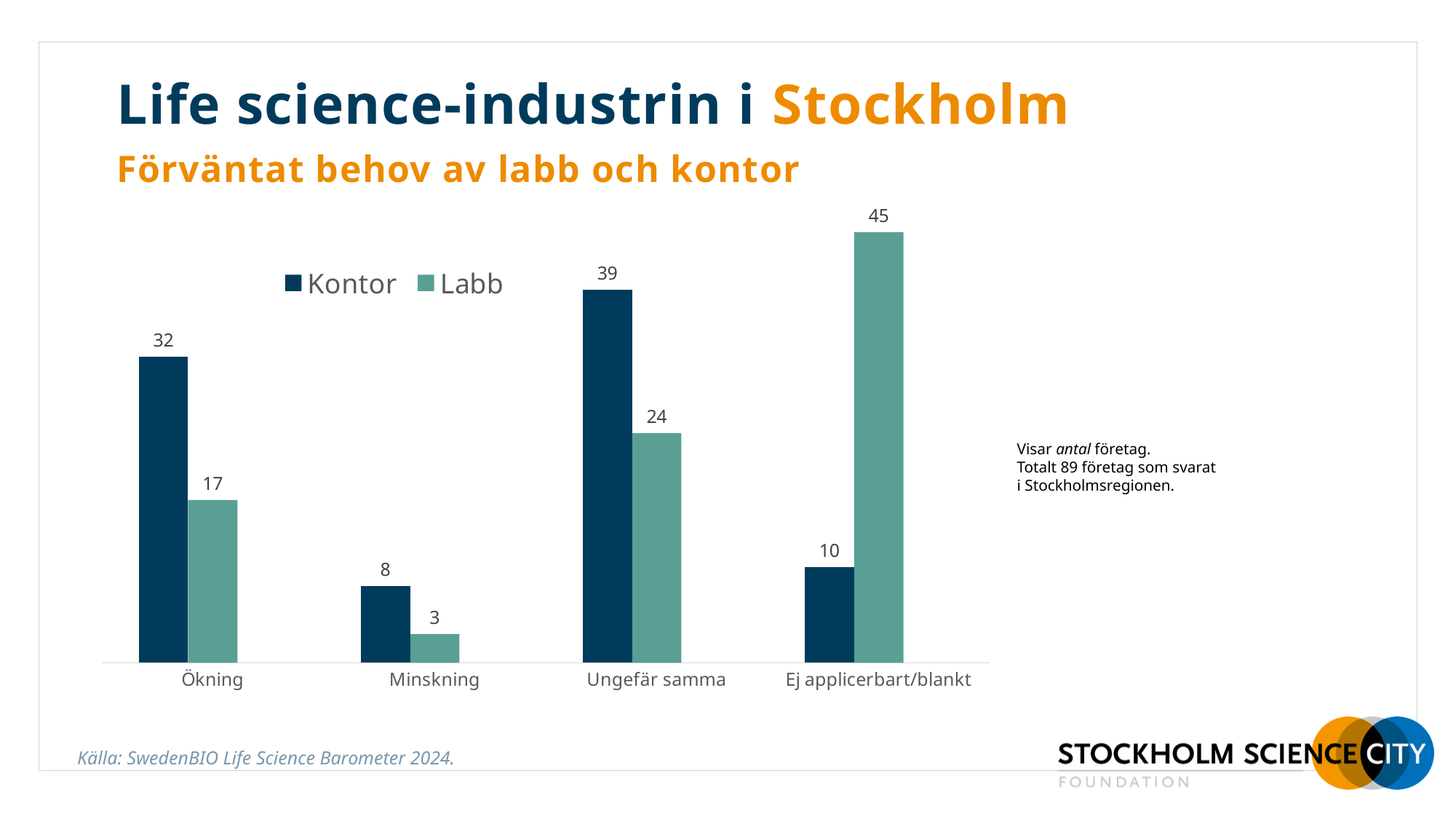
What is the Labb value for Minskning? 3 How many categories are shown on the x axis? 4 What is the Kontor value for Ökning? 32 Which category has the highest Kontor value? Ungefär samma Which is larger for Ej applicerbart/blankt, Kontor or Labb? Labb What are the two series named in the legend? Kontor and Labb What is the Labb value for Ej applicerbart/blankt? 45 What is the difference between the Kontor values for Ökning and Minskning? 24 What is the difference between the Kontor and Labb values for Ungefär samma? 15 What kind of chart is shown on the slide? Bar chart How many series does the legend list? 2 Which category has the lowest Labb value? Minskning